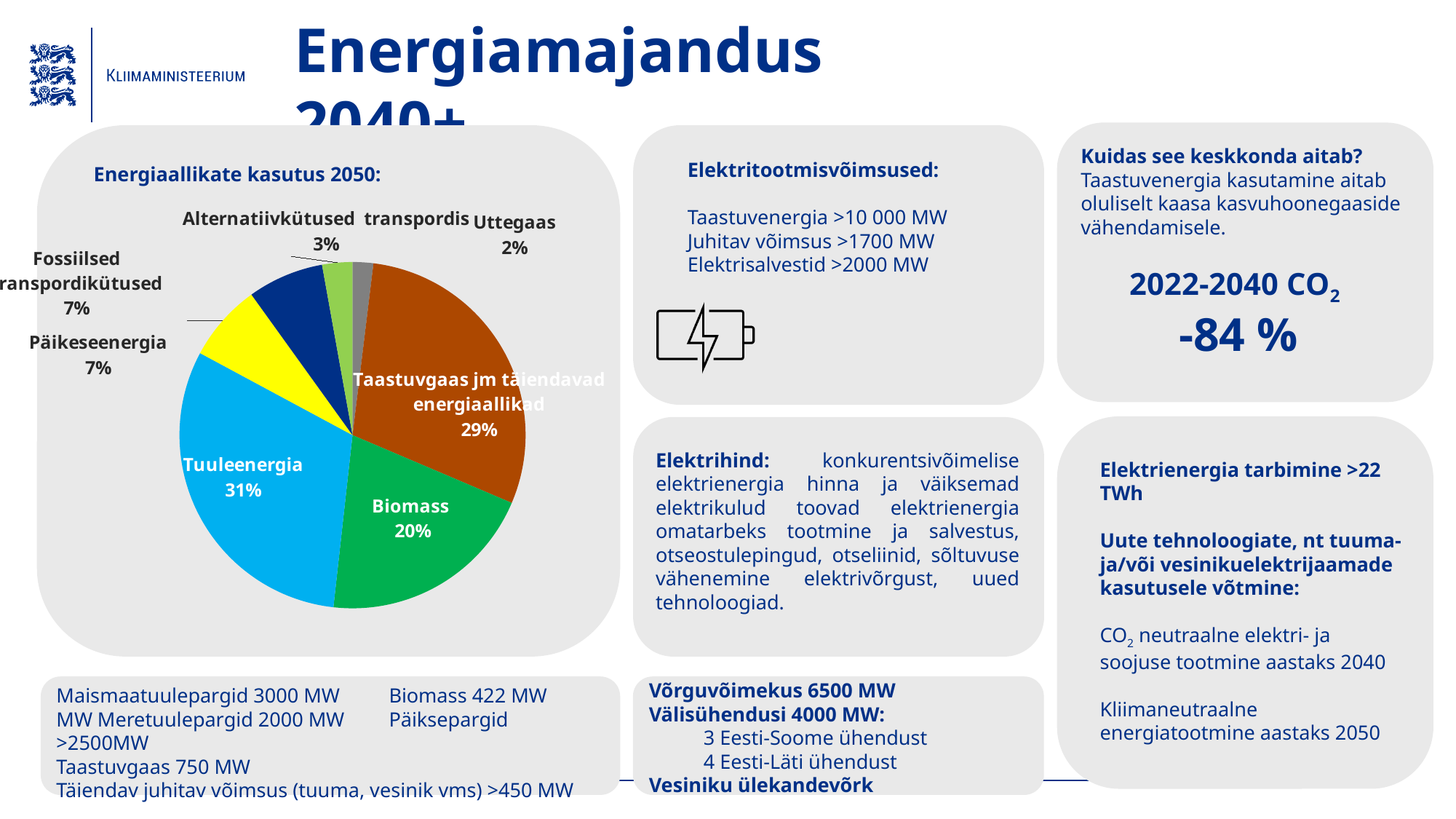
Which is larger, the share for Biomass or the share for Päikeseenergia? Biomass What is the difference in percentage points between Tuuleenergia and Biomass? 11 What share of the pie does Biomass have? 20% What colour is the Tuuleenergia slice of the pie chart? light blue What kind of chart is shown under "Energiaallikate kasutus 2050"? pie chart Which slice of the pie chart is the smallest? Uttegaas What share of the pie does Uttegaas have? 2% What share of the pie does Tuuleenergia have? 31% What share of the pie does Taastuvgaas jm täiendavad energiaallikad have? 29% Which slice of the pie chart is the largest? Tuuleenergia How many slices does the pie chart have? 7 What share of the pie does Alternatiivkütused transpordis have? 3%